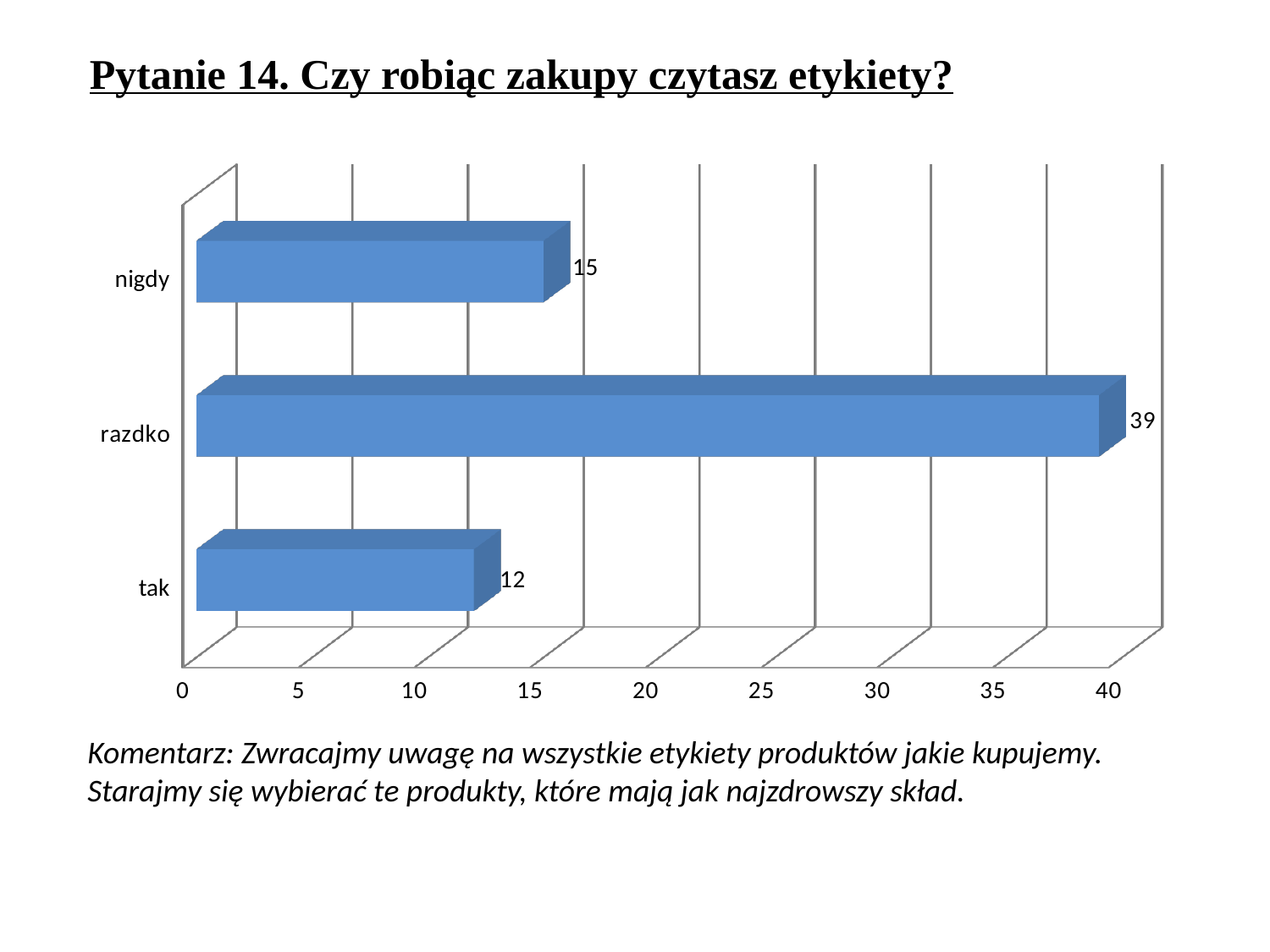
Which category has the highest value? razdko What is the value for "razdko"? 39 What is the difference between the values for "nigdy" and "tak"? 3 What is the difference between the values for "razdko" and "nigdy"? 24 Which category has the lowest value? tak What kind of chart is shown on the slide? bar chart Is the value for "razdko" greater or less than 35? greater Which is larger, the value for "nigdy" or the value for "tak"? nigdy What is the value for "nigdy"? 15 How many categories are shown in the chart? 3 What is the title of the slide above the chart? Pytanie 14. Czy robiąc zakupy czytasz etykiety? What is the value for "tak"? 12